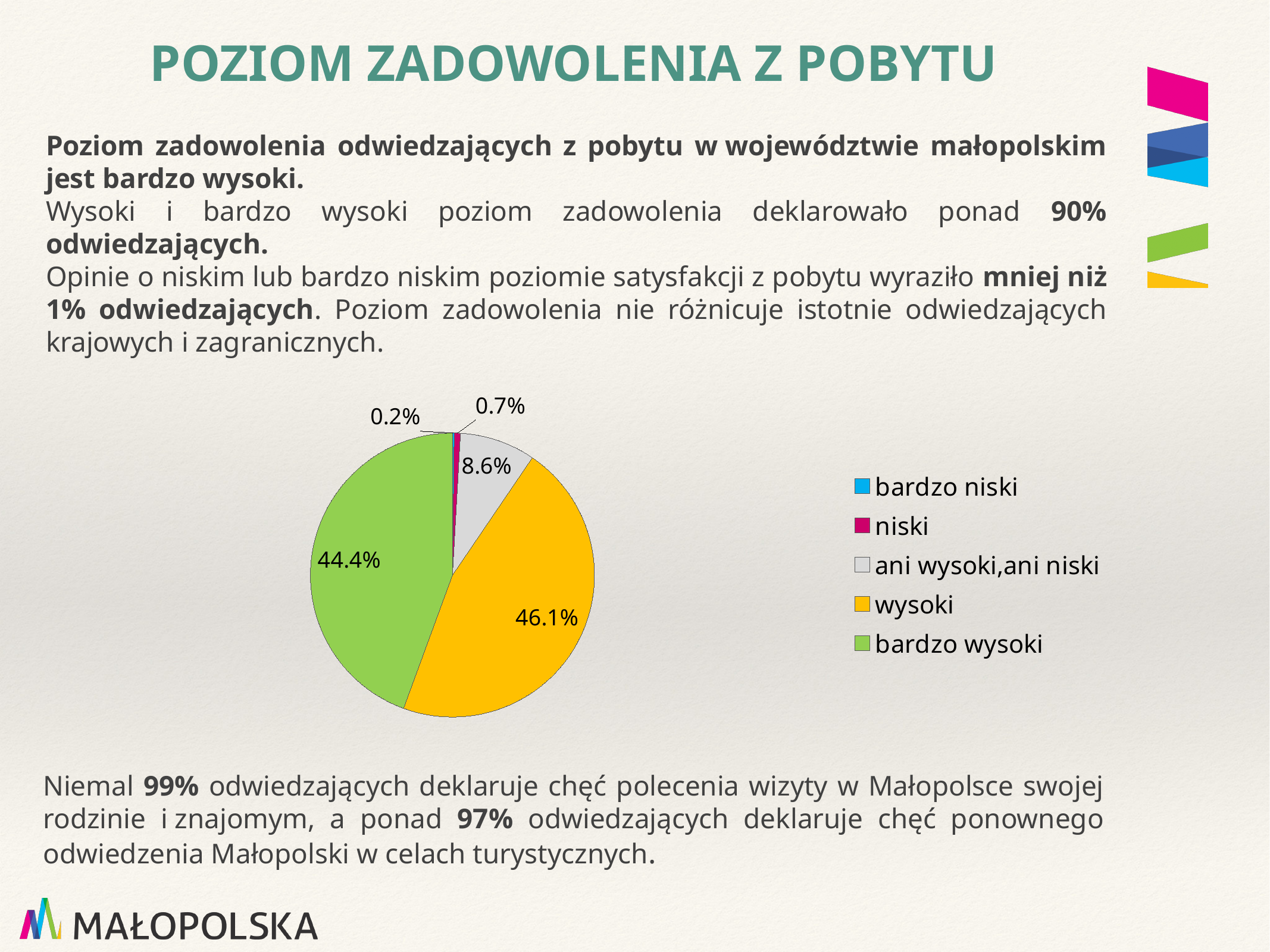
What is the difference between the 'wysoki' and 'bardzo wysoki' slices? 1.7% What percentage of the pie is the 'niski' slice? 0.7% What colour is the 'bardzo wysoki' slice in the pie chart? green Which category has the largest slice of the pie? wysoki What percentage of the pie is the 'bardzo niski' slice? 0.2% What percentage of the pie is the 'ani wysoki,ani niski' slice? 8.6% What percentage of the pie is the 'bardzo wysoki' slice? 44.4% What type of chart is shown on the slide? pie chart Which category has the smallest slice of the pie? bardzo niski What percentage of the pie is the 'wysoki' slice? 46.1% Which slice is larger, 'ani wysoki,ani niski' or 'bardzo wysoki'? bardzo wysoki How many categories does the pie chart have? 5